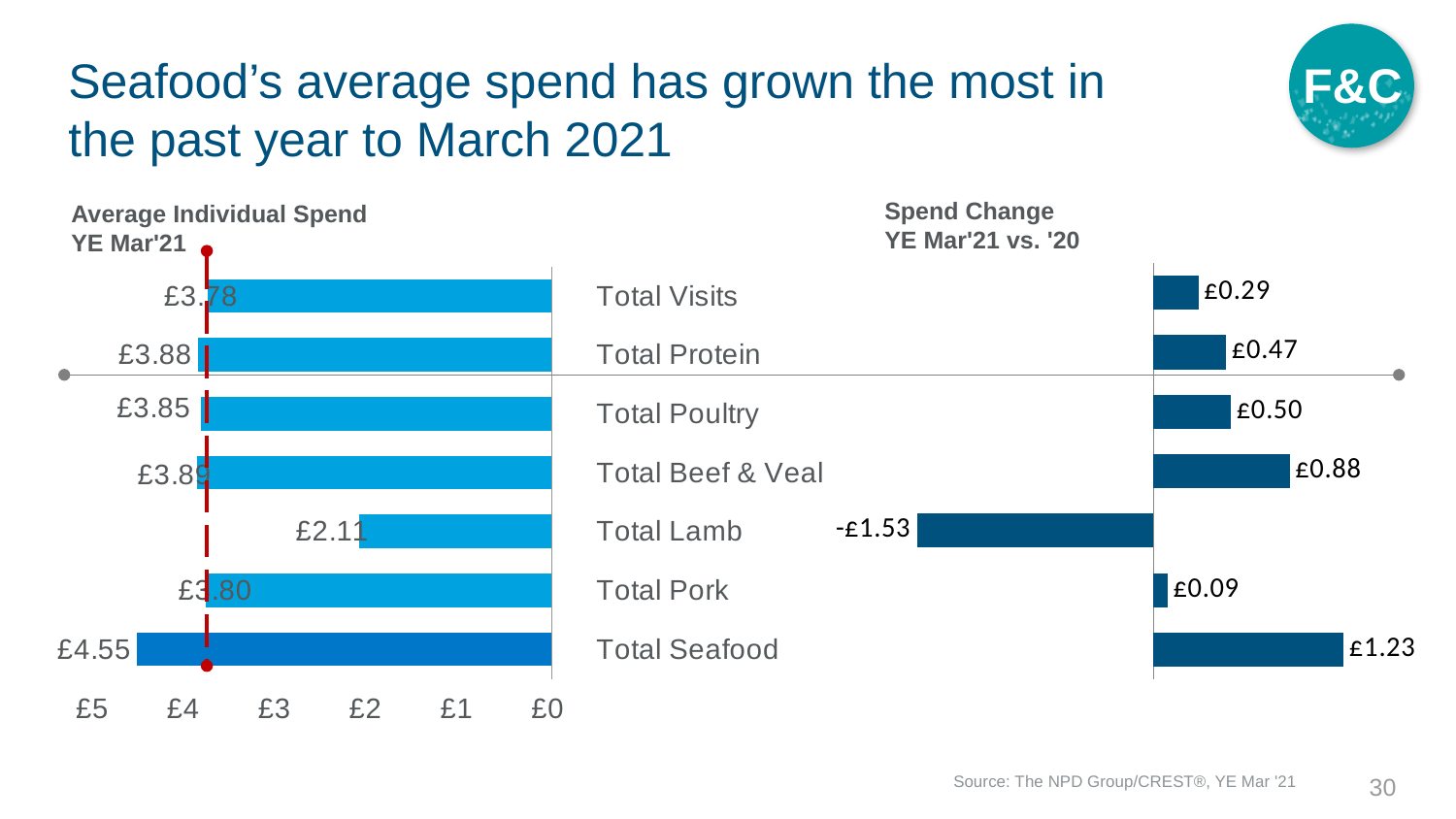
How many categories are shown in the 'Average Individual Spend YE Mar'21' chart? 7 In the 'Spend Change YE Mar'21 vs. '20' chart, what is the value for Total Lamb? -£1.53 In the 'Spend Change YE Mar'21 vs. '20' chart, what is the difference between Total Seafood and Total Beef & Veal? £0.35 In the 'Average Individual Spend YE Mar'21' chart, what is the difference between Total Seafood and Total Lamb? £2.44 In the 'Average Individual Spend YE Mar'21' chart, which category has the lowest average spend? Total Lamb In the 'Average Individual Spend YE Mar'21' chart, which category has the highest average spend? Total Seafood In the 'Spend Change YE Mar'21 vs. '20' chart, which category has the largest spend change? Total Seafood In the 'Spend Change YE Mar'21 vs. '20' chart, what is the value for Total Beef & Veal? £0.88 In the 'Spend Change YE Mar'21 vs. '20' chart, what is the value for Total Seafood? £1.23 What kind of chart is the 'Average Individual Spend YE Mar'21' chart on the left? bar chart In the 'Average Individual Spend YE Mar'21' chart, what is the value for Total Lamb? £2.11 In the 'Average Individual Spend YE Mar'21' chart, what is the value for Total Seafood? £4.55